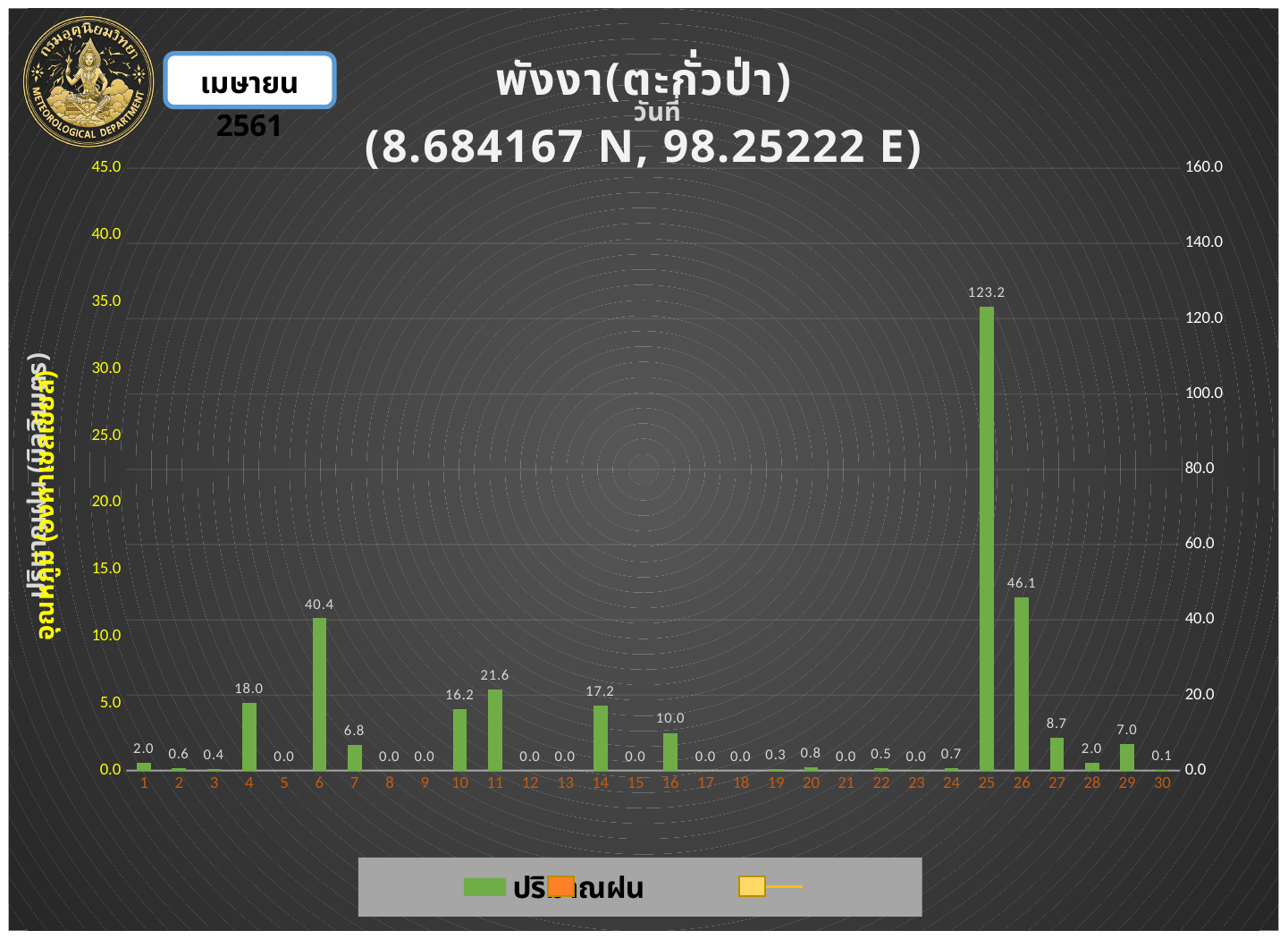
How many days are shown on the x axis of the chart? 30 What is the rainfall value for day 11? 21.6 Which day has the highest rainfall value? 25 What is the rainfall value for day 26? 46.1 What is the difference between the rainfall values for day 6 and day 4? 22.4 What is the rainfall value for day 25? 123.2 What type of chart is shown on the slide? bar chart What is the name of the station in the chart title? พังงา(ตะกั่วป่า) Which has a larger rainfall value, day 27 or day 29? day 27 Which has a larger rainfall value, day 10 or day 14? day 14 What is the rainfall value for day 6? 40.4 What is the difference between the rainfall values for day 25 and day 26? 77.1